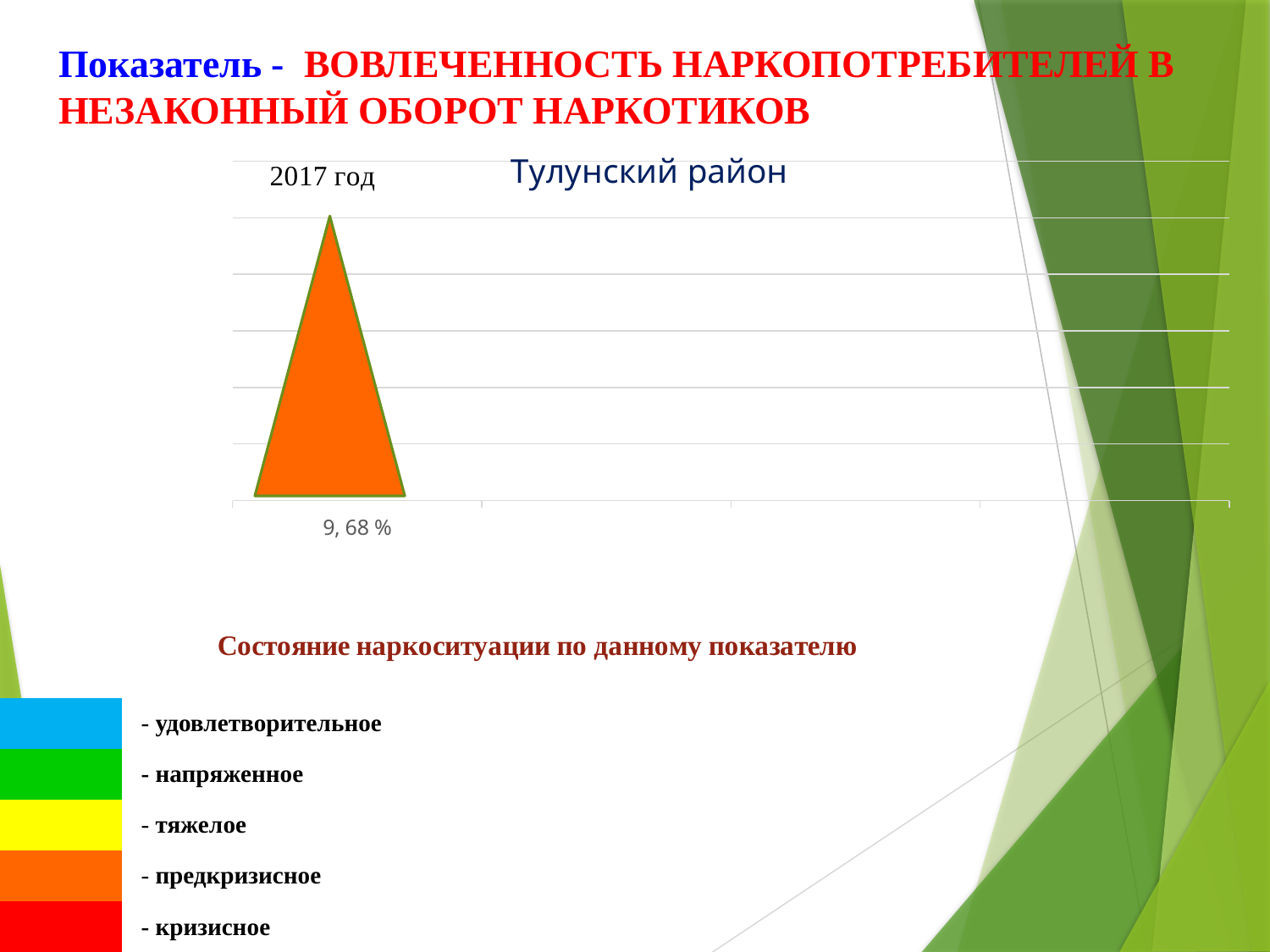
What is the title of the chart on the slide? Тулунский район What kind of chart is shown on the slide? bar chart How many categories (bars) are plotted on the Тулунский район chart? 1 Which year is labelled on the chart's only bar? 2017 год What value is shown for 2017 год on the Тулунский район chart? 9, 68 %